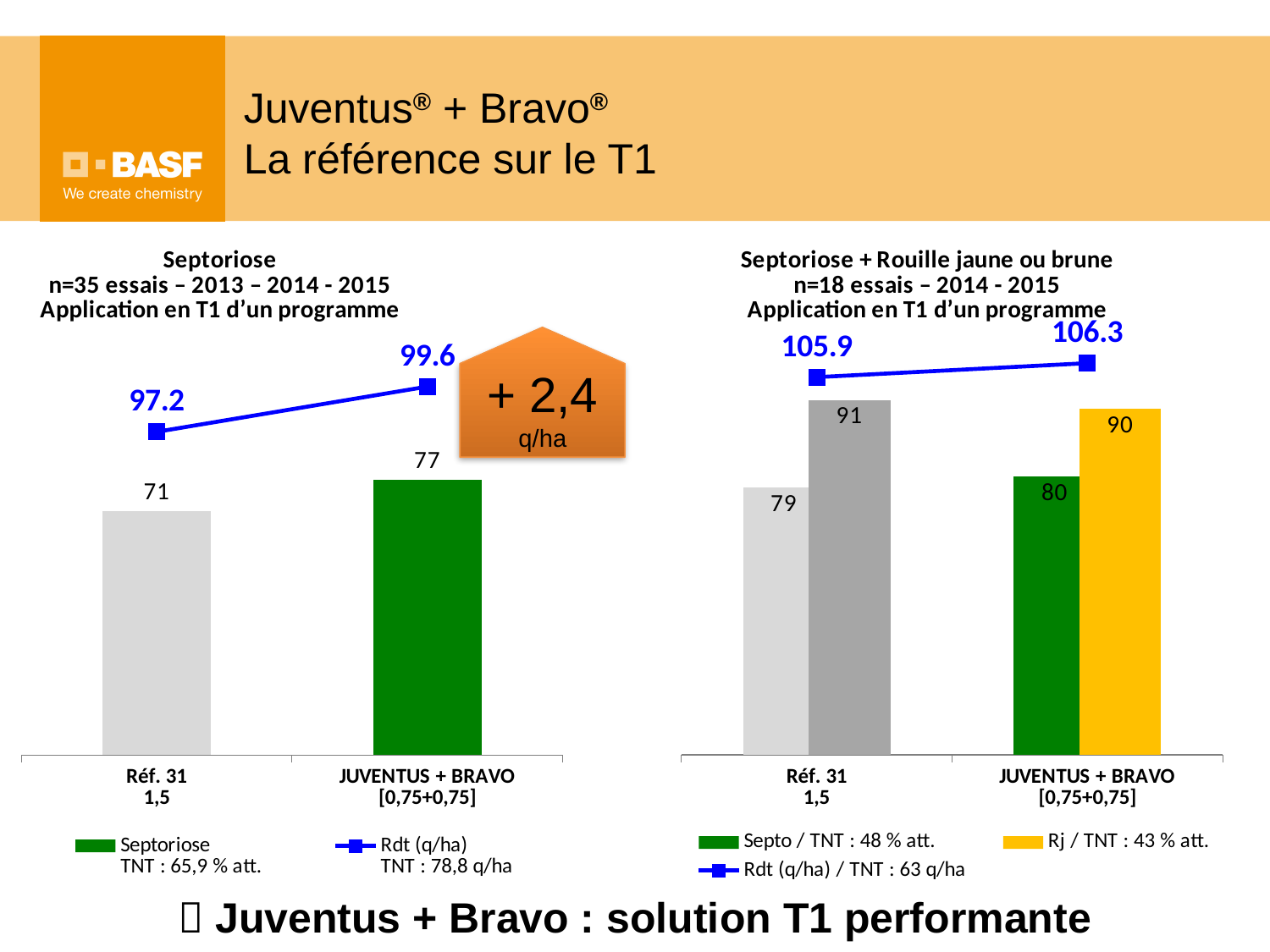
In the left chart (Septoriose, n=35 essais), which category has the higher Septoriose bar? JUVENTUS + BRAVO [0,75+0,75] In the right chart (Septoriose + Rouille jaune ou brune), which is larger for Réf. 31: the Septo bar or the Rj bar? Rj In the right chart (Septoriose + Rouille jaune ou brune), how many series does the legend list? 3 In the left chart (Septoriose, n=35 essais), what is the Rdt (q/ha) value for Réf. 31 1,5? 97.2 In the right chart (Septoriose + Rouille jaune ou brune), what is the Septo value for JUVENTUS + BRAVO [0,75+0,75]? 80 In the right chart (Septoriose + Rouille jaune ou brune), what is the difference between the Rj values of Réf. 31 and JUVENTUS + BRAVO? 1 In the left chart (Septoriose, n=35 essais), how many series does the legend list? 2 In the left chart (Septoriose, n=35 essais), what is the difference in Rdt (q/ha) between JUVENTUS + BRAVO and Réf. 31? 2.4 In the right chart (Septoriose + Rouille jaune ou brune), does the Rdt (q/ha) line rise or fall from Réf. 31 to JUVENTUS + BRAVO? rise In the right chart (Septoriose + Rouille jaune ou brune), what is the Rdt (q/ha) value for JUVENTUS + BRAVO [0,75+0,75]? 106.3 In the right chart (Septoriose + Rouille jaune ou brune), what is the Rj value for Réf. 31 1,5? 91 In the left chart (Septoriose, n=35 essais), what is the Septoriose value for JUVENTUS + BRAVO [0,75+0,75]? 77